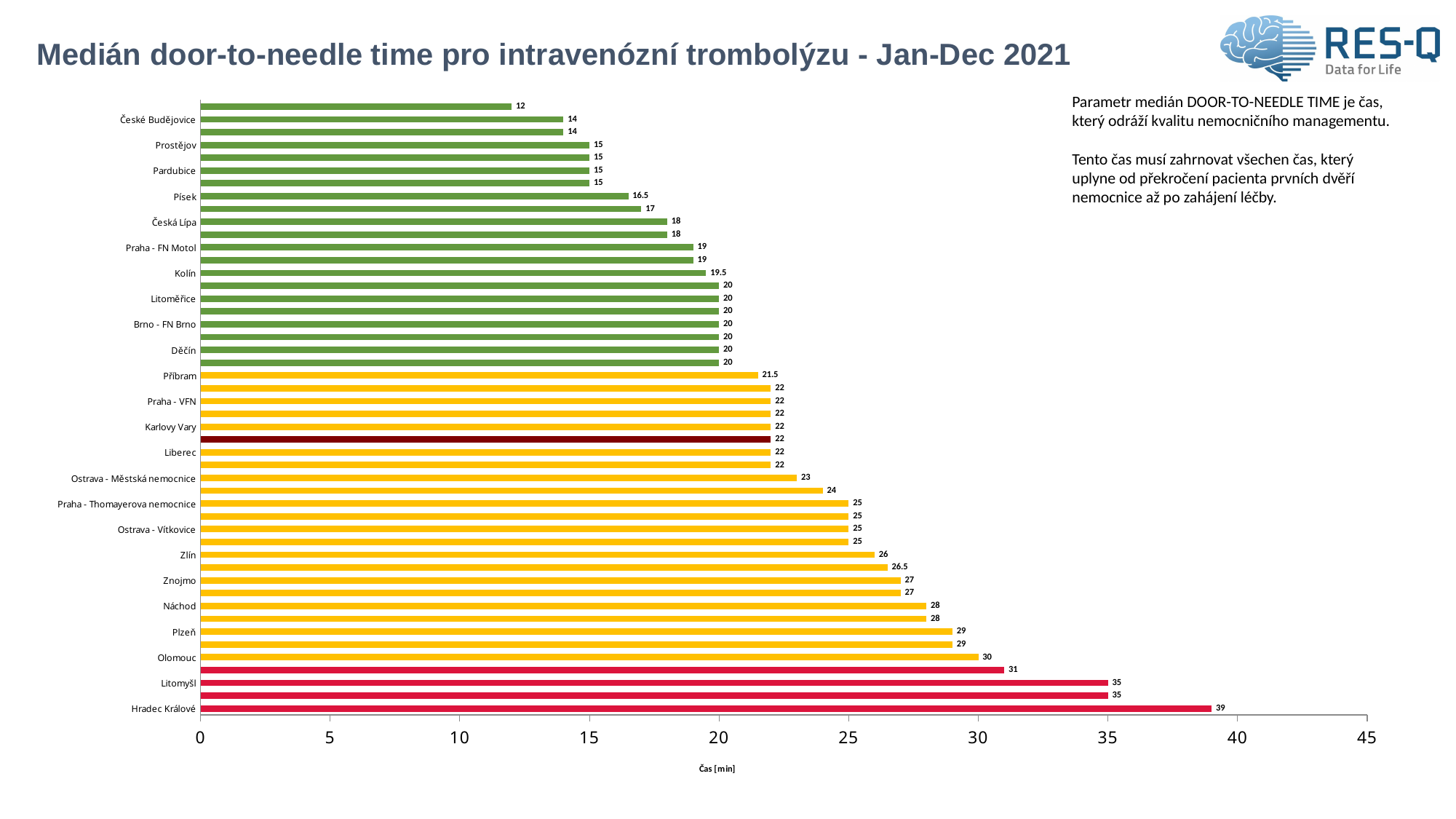
What is the median door-to-needle time for Olomouc? 30 Is the value for Litomyšl greater or less than 30? greater Which has a larger median door-to-needle time, Zlín or Písek? Zlín What is the median door-to-needle time for Hradec Králové? 39 What is the label of the horizontal axis? Čas [min] What is the median door-to-needle time for Litomyšl? 35 Which labelled hospital has the highest median door-to-needle time? Hradec Králové What is the median door-to-needle time for Příbram? 21.5 What type of chart is shown on the slide? bar chart What is the difference between the median door-to-needle times of Hradec Králové and Olomouc? 9 What is the median door-to-needle time for Písek? 16.5 What is the median door-to-needle time for Kolín? 19.5